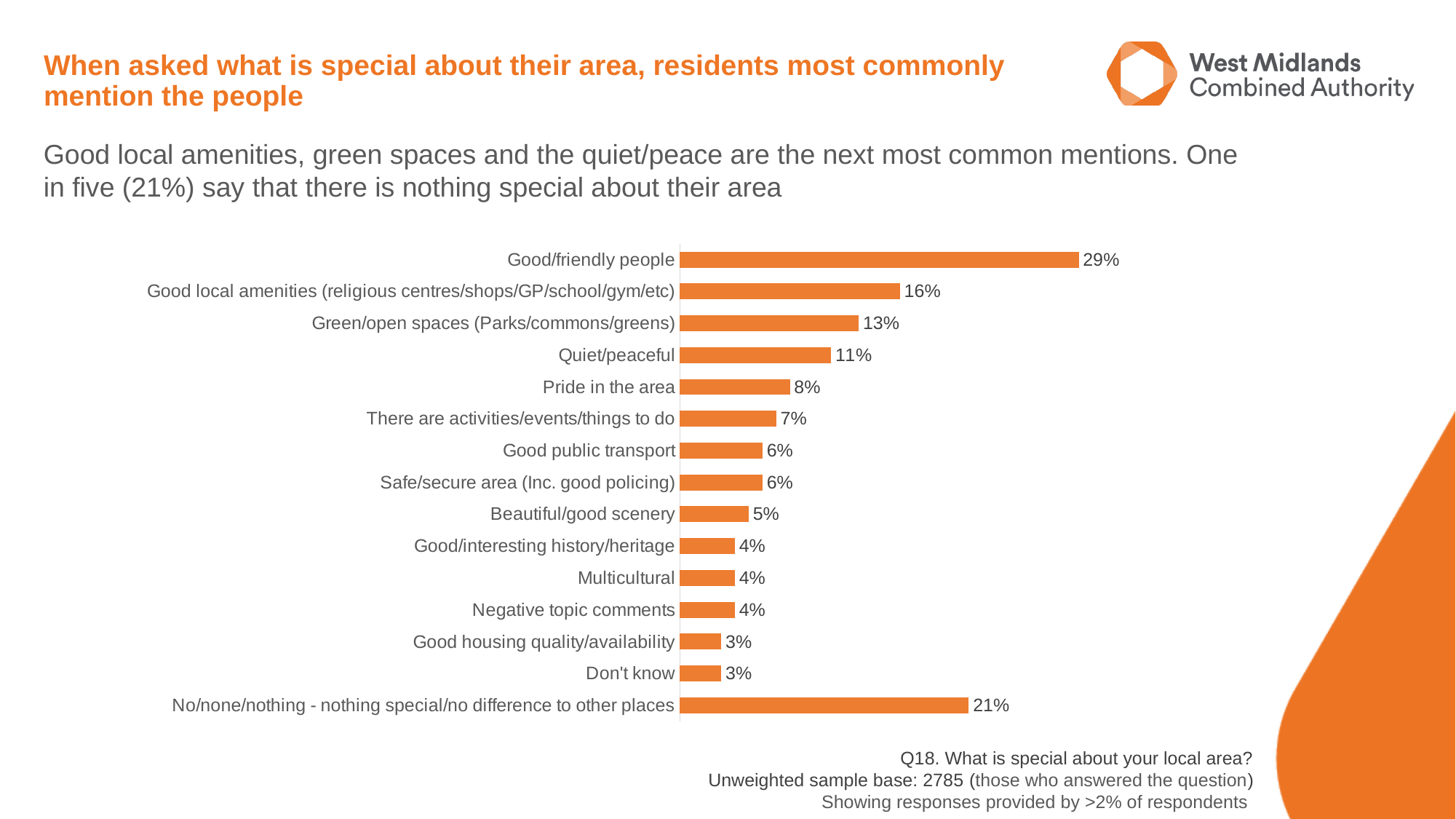
What is the value for No/none/nothing - nothing special/no difference to other places? 21% Which is larger, the value for No/none/nothing - nothing special/no difference to other places or the value for Good local amenities (religious centres/shops/GP/school/gym/etc)? No/none/nothing - nothing special/no difference to other places What colour are the bars in the chart? Orange Which is larger, the value for Beautiful/good scenery or the value for Multicultural? Beautiful/good scenery What is the value for Good public transport? 6% What kind of chart is shown on the slide? Bar chart What is the difference between the values for Good/friendly people and Good local amenities (religious centres/shops/GP/school/gym/etc)? 13% What percentage of residents mentioned Good/friendly people as what is special about their area? 29% What is the difference between the values for Green/open spaces (Parks/commons/greens) and Pride in the area? 5% What is the value for Quiet/peaceful? 11% How many categories are shown in the chart? 15 Which category has the highest value in the chart? Good/friendly people